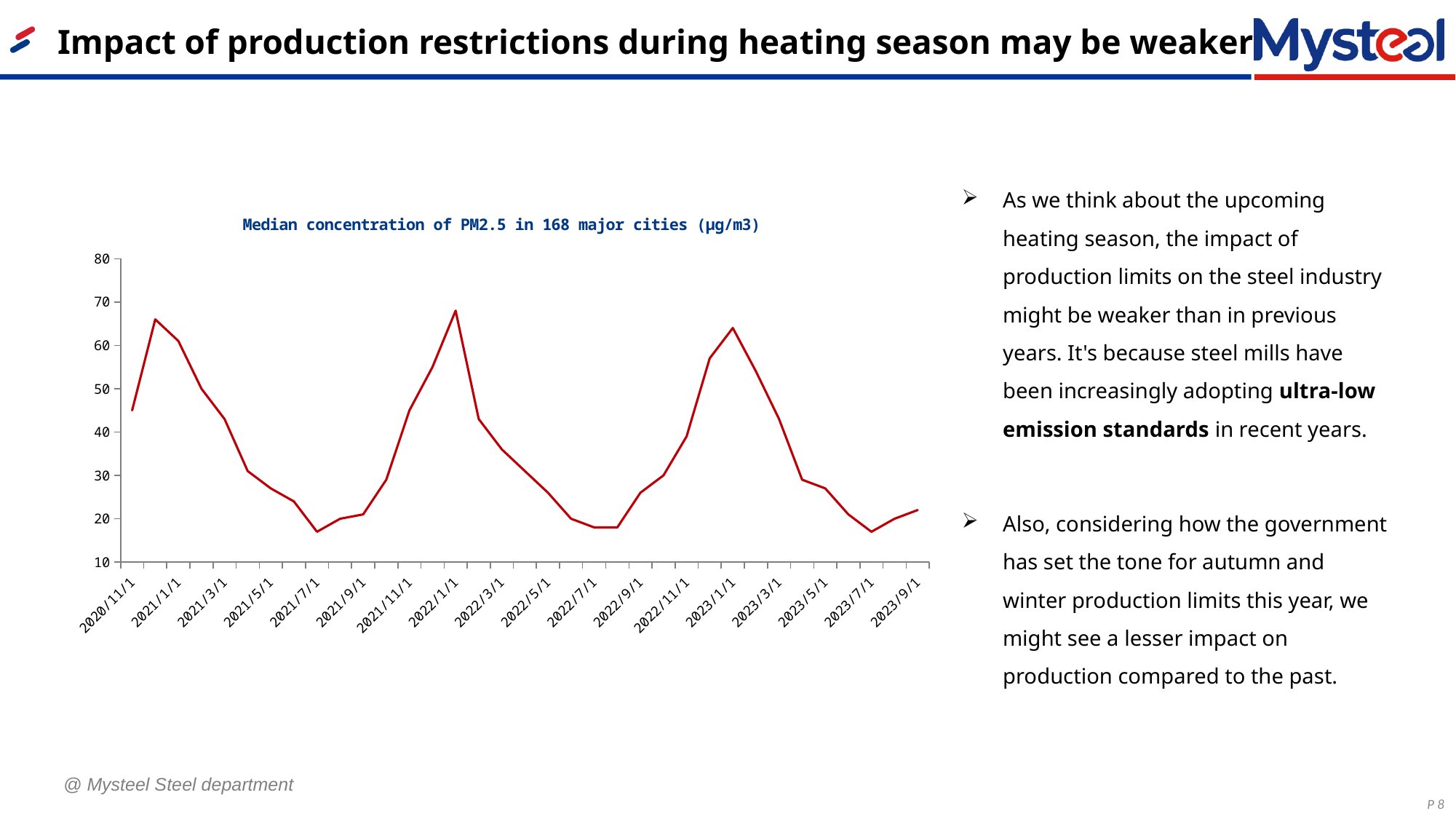
How many date labels are shown on the x axis of the chart? 18 Do the values rise or fall between 2022/1/1 and 2022/7/1? fall Is the value around 2021/7/1 greater or less than 20? less What kind of chart is shown on the slide? line chart Which is larger, the value around 2022/1/1 or the value around 2022/7/1? 2022/1/1 Is the value around 2022/7/1 greater or less than 30? less Do the values rise or fall between 2022/7/1 and 2023/1/1? rise Is the value at 2020/11/1 greater or less than 40? greater What colour is the line plotted in the chart? red What is the title of the chart? Median concentration of PM2.5 in 168 major cities (μg/m3) How many data series are plotted in the chart? 1